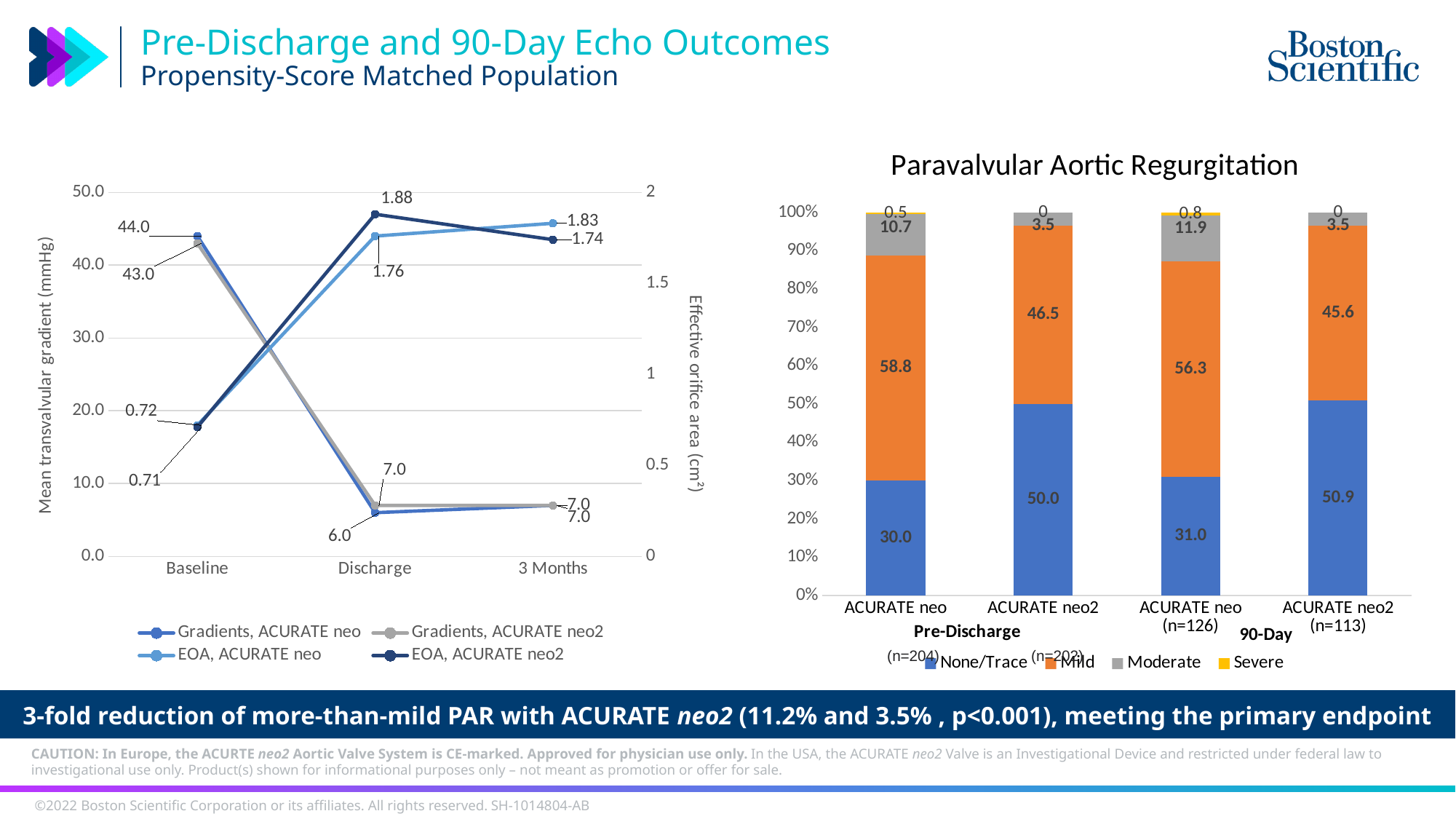
In the Paravalvular Aortic Regurgitation chart, what is the None/Trace value for ACURATE neo2 at 90-Day? 50.9 In the Paravalvular Aortic Regurgitation chart, what is the Mild value for ACURATE neo at Pre-Discharge? 58.8 In the Paravalvular Aortic Regurgitation chart, what is the Moderate value for ACURATE neo at 90-Day? 11.9 In the left line chart, what is the EOA, ACURATE neo2 value at Discharge? 1.88 In the left line chart, do the Gradients, ACURATE neo2 values rise or fall from Baseline to Discharge? Fall What type of chart is the chart on the left of the slide? Line chart In the Paravalvular Aortic Regurgitation chart, what colour represents the Mild category? Orange In the Paravalvular Aortic Regurgitation chart, what is the difference between the Moderate values for ACURATE neo and ACURATE neo2 at Pre-Discharge? 7.2 In the Paravalvular Aortic Regurgitation chart, which bar has the highest None/Trace value? ACURATE neo2 (90-Day) In the left line chart, how many series does the legend list? 4 In the Paravalvular Aortic Regurgitation chart, how many series does the legend list? 4 In the left line chart, what is the Gradients, ACURATE neo value at Baseline? 44.0